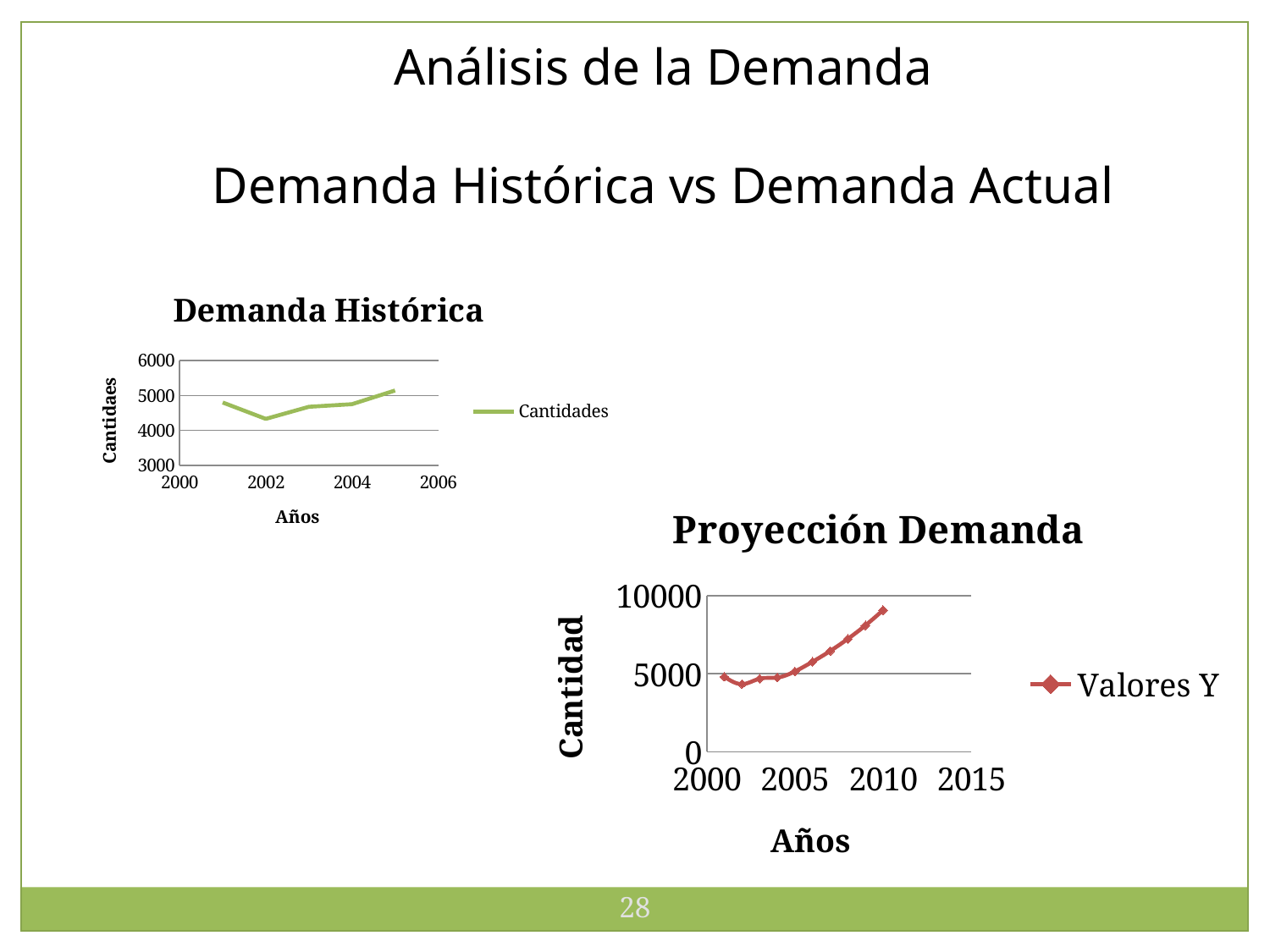
What is the name of the series in the "Proyección Demanda" chart legend? Valores Y In the "Proyección Demanda" chart, is the value for 2010 greater or less than 5000? greater In the "Demanda Histórica" chart, which year has the lowest value? 2002 In the "Demanda Histórica" chart, is the value for 2005 greater or less than 5000? greater What type of chart is the "Demanda Histórica" chart? line chart In the "Proyección Demanda" chart, do the values rise or fall from 2005 to 2010? rise In the "Proyección Demanda" chart, which year has the highest value? 2010 What is the name of the series in the "Demanda Histórica" chart legend? Cantidades In the "Demanda Histórica" chart, is the value for 2002 greater or less than 5000? less How many series does the legend of the "Demanda Histórica" chart list? 1 In the "Proyección Demanda" chart, which year has the lowest value? 2002 In the "Demanda Histórica" chart, which year has the highest value? 2005